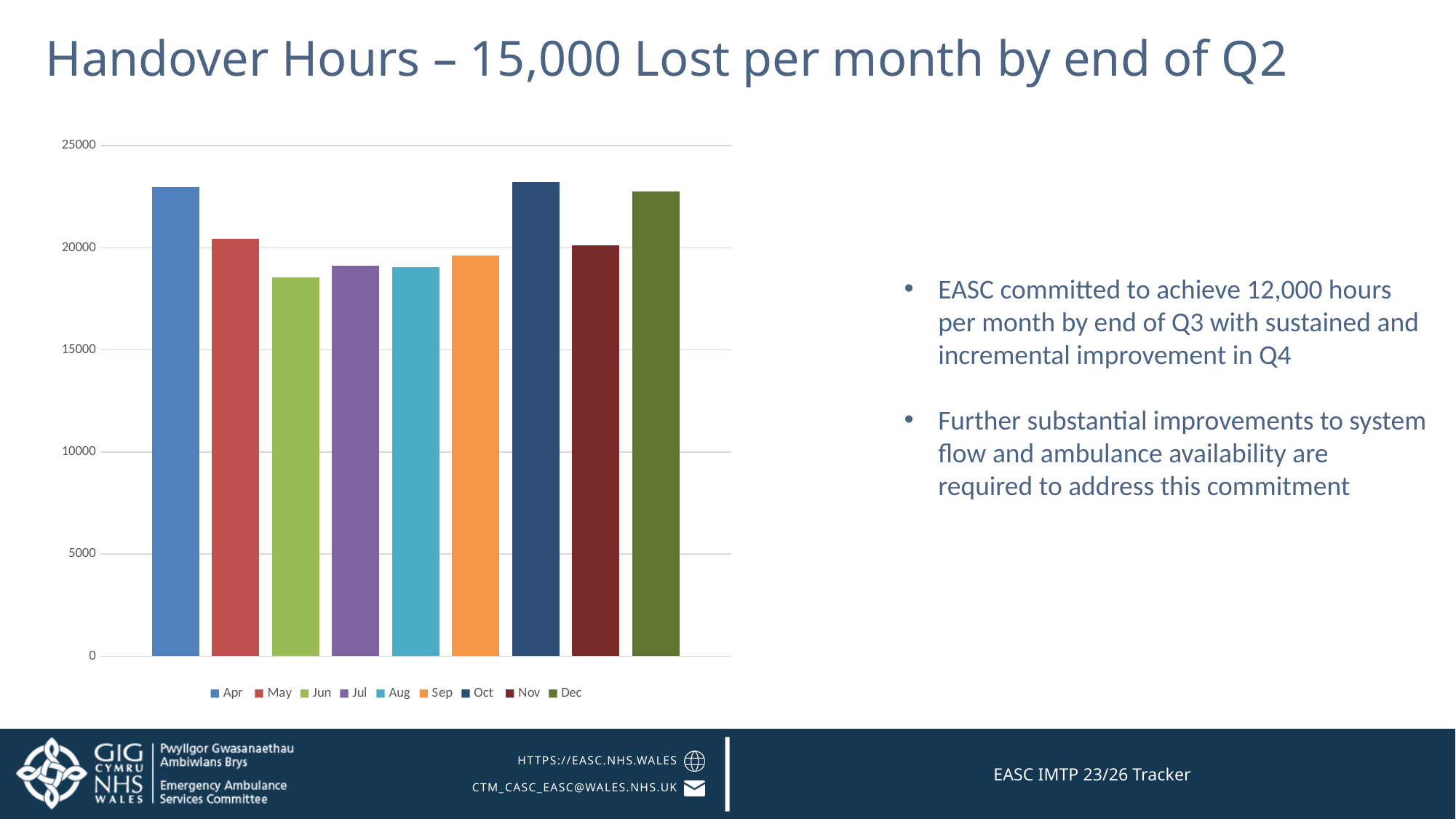
Is the value for Sep greater or less than 20000? less Is the value for Apr greater or less than 20000? greater How many bars are plotted in the chart? 9 Is the value for Oct greater or less than 20000? greater Which is larger, the value for Nov or the value for Oct? Oct How many entries does the chart legend list? 9 Which is larger, the value for Apr or the value for May? Apr What kind of chart is shown on the slide? bar chart Which is larger, the value for Jun or the value for Dec? Dec What is the title of the slide containing the chart? Handover Hours – 15,000 Lost per month by end of Q2